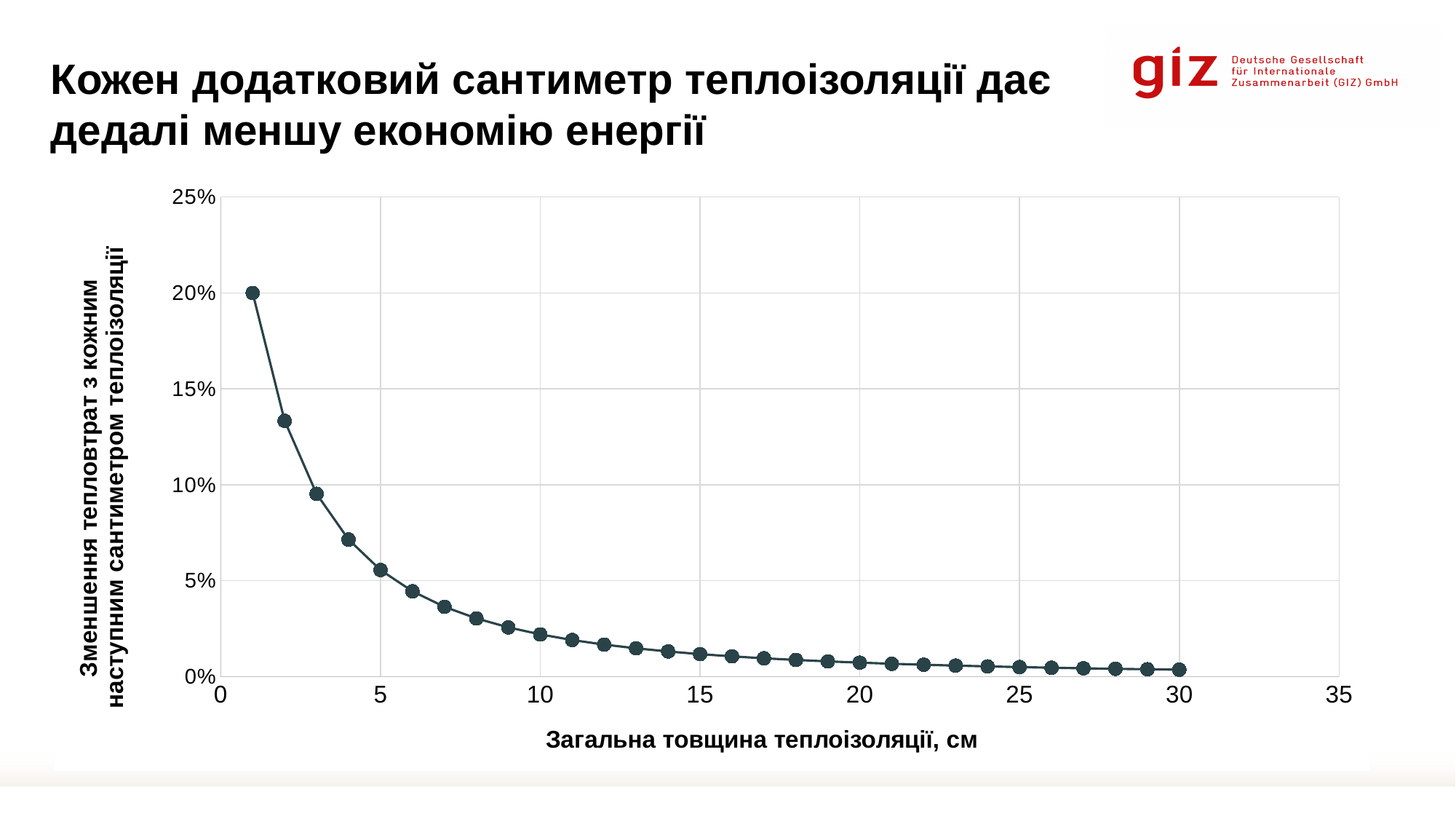
Is the value at 2 cm of insulation thickness greater or less than 10%? greater What kind of chart is shown on the slide? line chart How many data points are plotted on the chart? 30 What is the value plotted at a total insulation thickness of 1 cm? 20% Which has the larger plotted value: 2 cm or 5 cm of insulation thickness? 2 cm Is the value at 10 cm of insulation thickness greater or less than 5%? less Do the plotted values rise or fall as the insulation thickness increases along the x axis? fall At which insulation thickness is the plotted value highest? 1 cm What is the title of the x axis? Загальна товщина теплоізоляції, см What is the highest value shown on the y axis? 25%